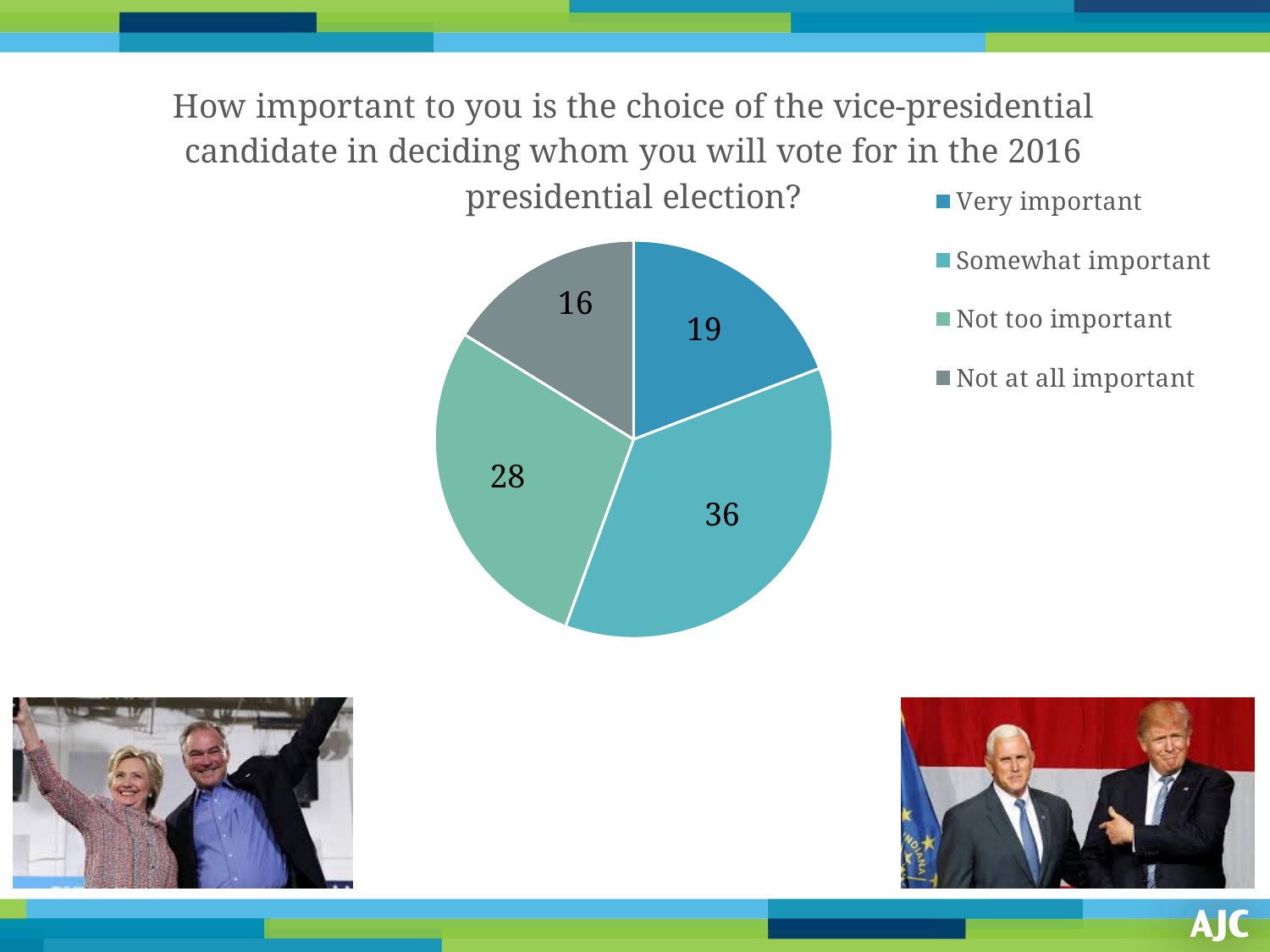
Which response category has the smallest slice of the pie? Not at all important How many slices does the pie chart have? 4 What value is shown for the Not at all important slice? 16 Which legend entry is shown in grey? Not at all important What value is shown for the Somewhat important slice? 36 What is the difference between the Very important and Not at all important values? 3 Which is larger, the value for Not too important or the value for Very important? Not too important What type of chart is shown on the slide? Pie chart What value is shown for the Not too important slice? 28 What is the difference between the Somewhat important and Not too important values? 8 What value is shown for the Very important slice? 19 Which response category has the largest slice of the pie? Somewhat important